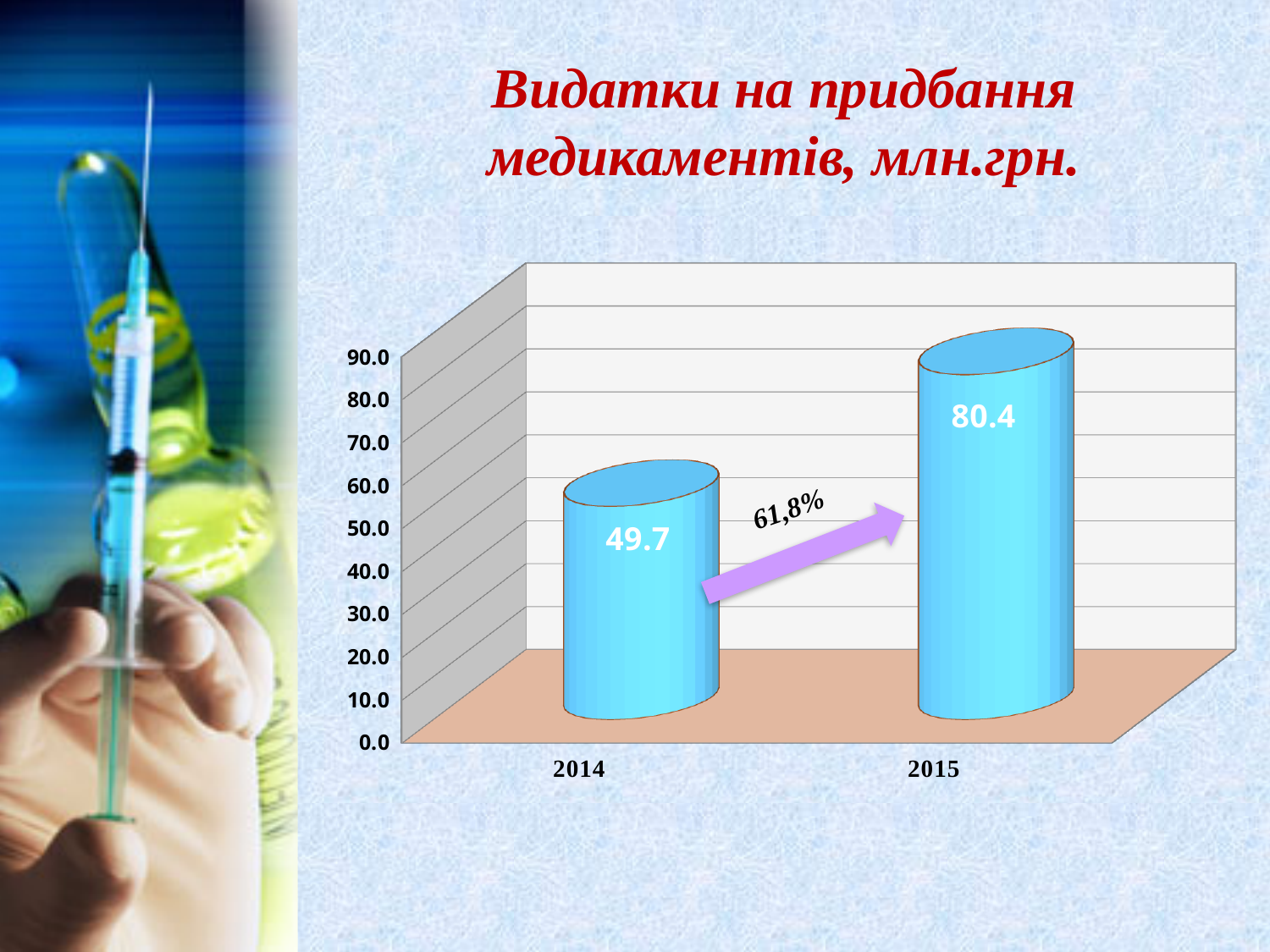
Which year has the lowest value? 2014 Which year has the highest value? 2015 What kind of chart is shown on the slide? bar chart Do the values rise or fall from 2014 to 2015? rise What is the value for 2015? 80.4 What is the value for 2014? 49.7 Is the value for 2014 greater or less than 60.0? less How many categories are shown on the x axis? 2 What is the difference between the values for 2015 and 2014? 30.7 Is the value for 2015 greater or less than 70.0? greater What percentage change is written on the arrow between the two bars? 61,8% Which is larger, the value for 2014 or the value for 2015? 2015